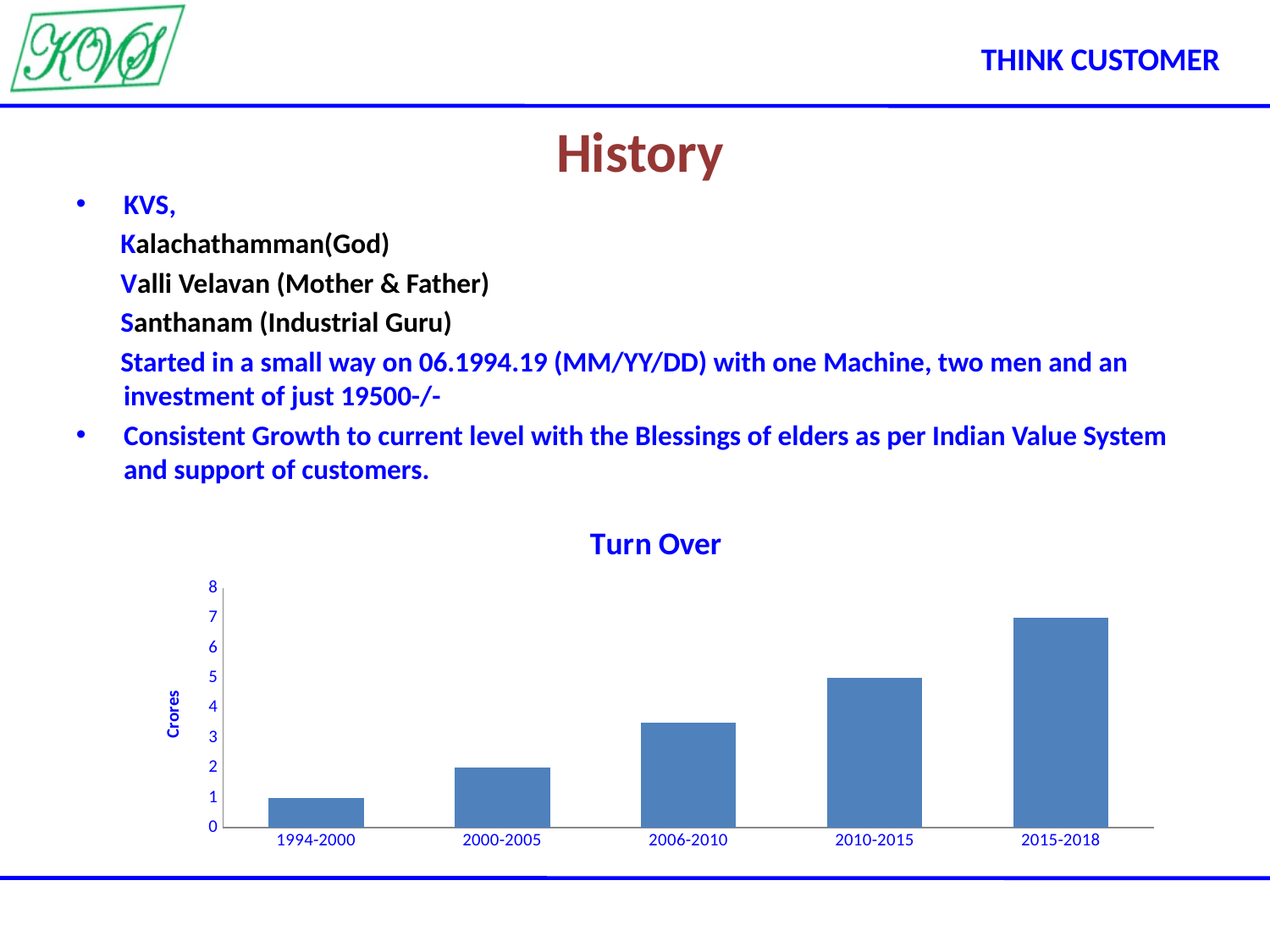
Is the turnover for 2006-2010 greater or less than 3? greater What is the label on the y axis of the Turn Over chart? Crores Which period has the lowest turnover in the Turn Over chart? 1994-2000 How many periods are shown on the x axis of the Turn Over chart? 5 What is the turnover for 2010-2015 in the Turn Over chart? 5 Which period has the highest turnover in the Turn Over chart? 2015-2018 What is the turnover for 1994-2000 in the Turn Over chart? 1 What kind of chart is the Turn Over chart? bar chart Do the turnover values rise or fall from 1994-2000 to 2015-2018? rise Which is larger in the Turn Over chart, the turnover for 2000-2005 or for 2010-2015? 2010-2015 What is the turnover for 2015-2018 in the Turn Over chart? 7 Is the turnover for 2006-2010 greater or less than 4? less